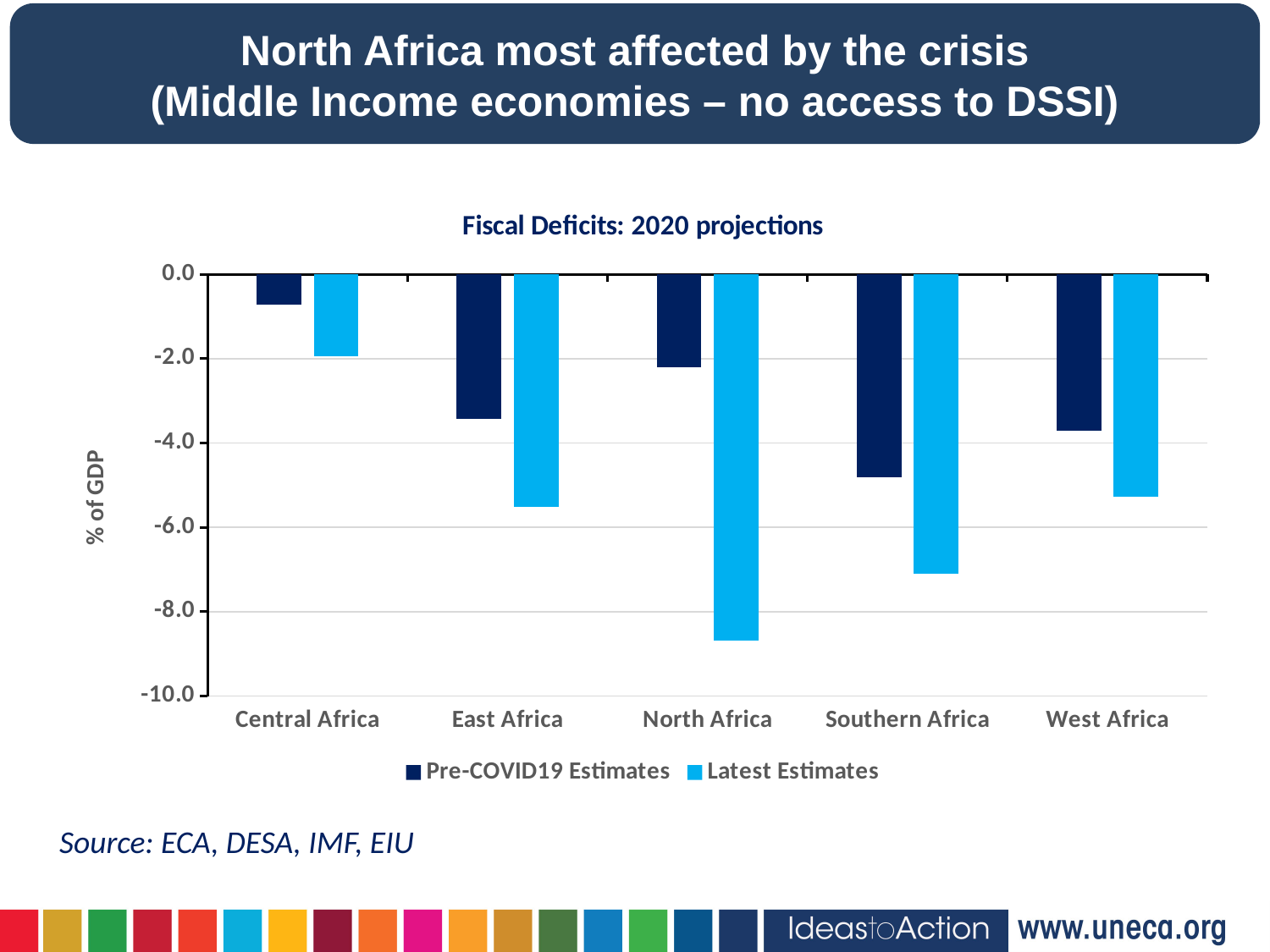
What is the title of the chart? Fiscal Deficits: 2020 projections Which region has the most negative Latest Estimates value? North Africa Which is more negative: the Pre-COVID19 Estimates value for North Africa or for Southern Africa? Southern Africa How many regions are shown on the x axis of the chart? 5 Is the Latest Estimates value for North Africa greater or less than -8.0? less Is the Pre-COVID19 Estimates value for Central Africa greater or less than -2.0? greater Which region has the Latest Estimates value closest to zero? Central Africa Is the Latest Estimates value for Southern Africa greater or less than -6.0? less What is the label on the vertical axis of the chart? % of GDP How many series does the chart's legend list? 2 What type of chart is shown on the slide? Bar chart Which region has the most negative Pre-COVID19 Estimates value? Southern Africa